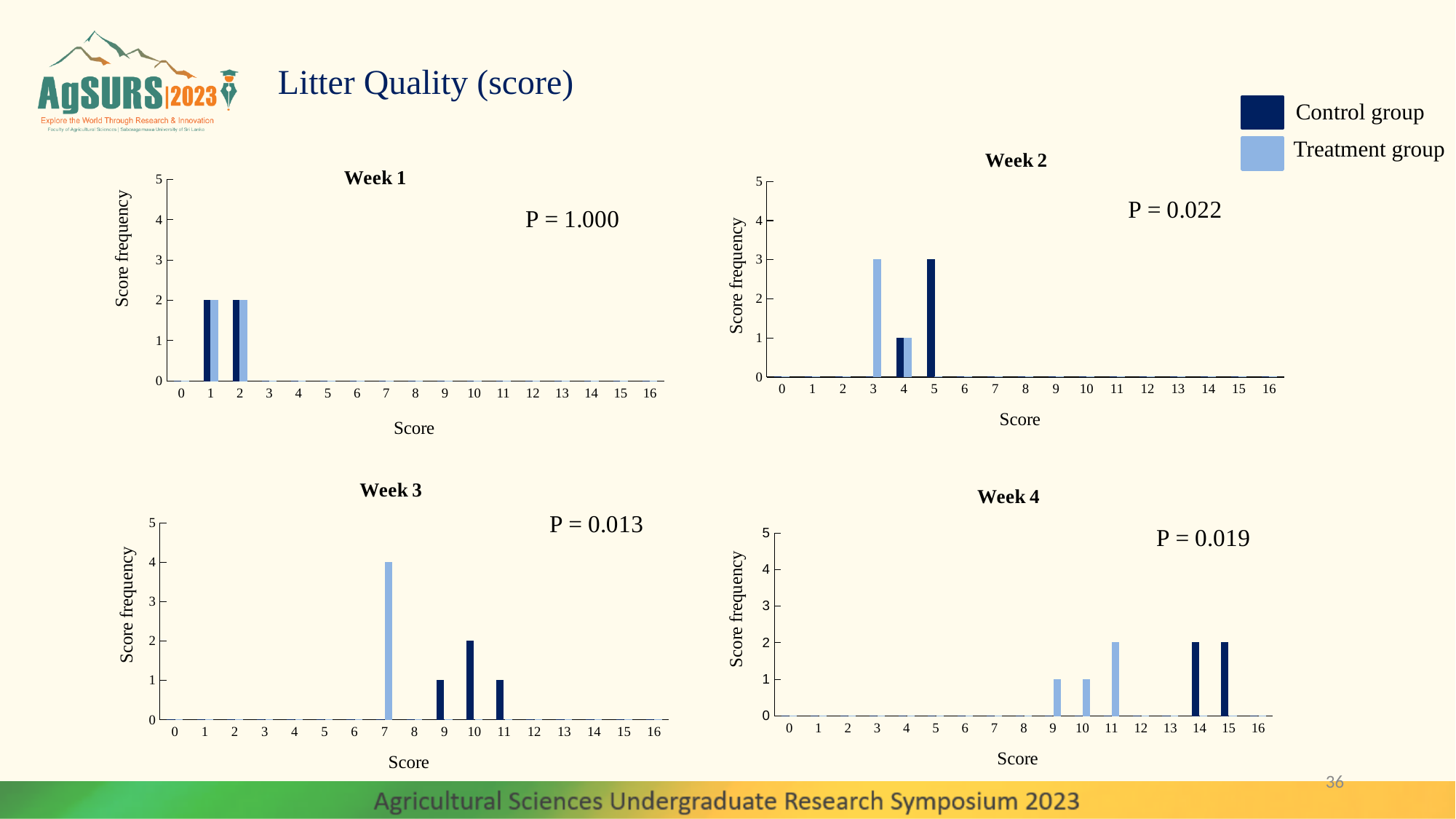
In the Week 1 chart, what is the score frequency of the control group at score 1? 2 How many score categories are shown on the x axis of the Week 2 chart? 17 In the Week 3 chart, which score has the highest frequency? 7 In the Week 2 chart, what is the score frequency of the control group at score 5? 3 In the Week 4 chart, which is larger: the treatment group frequency at score 11 or the treatment group frequency at score 9? score 11 What P value is shown on the Week 3 chart? P = 0.013 How many groups does the legend list? 2 In the Week 2 chart, which score has the highest frequency for the treatment group? 3 What kind of chart is the Week 1 chart? bar chart In the Week 4 chart, what is the score frequency of the treatment group at score 11? 2 In the Week 3 chart, what is the score frequency of the treatment group at score 7? 4 In the Week 3 chart, what is the difference between the treatment group frequency at score 7 and the control group frequency at score 10? 2